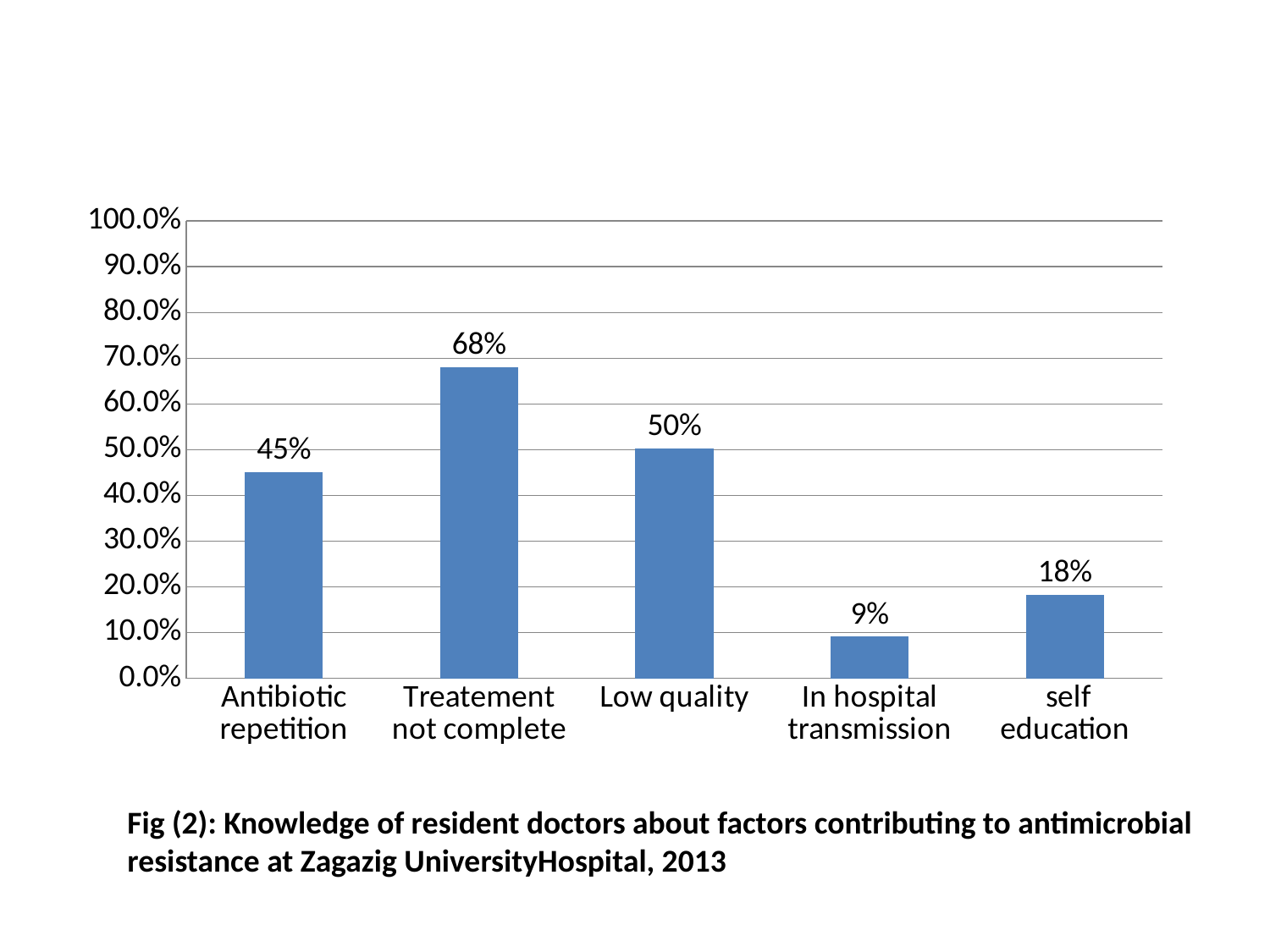
What is the difference between the values for Antibiotic repetition and self education? 27% What is the difference between the values for Treatement not complete and Low quality? 18% What kind of chart is shown on the slide? Bar chart What is the highest value shown on the y axis? 100.0% What is the value for Treatement not complete? 68% What is the value for In hospital transmission? 9% How many categories are shown on the x axis? 5 Which category has the lowest value? In hospital transmission Which category has the highest value? Treatement not complete Which is larger, the value for Antibiotic repetition or the value for Low quality? Low quality What is the value for self education? 18% Is the value for Antibiotic repetition greater or less than 40.0%? greater